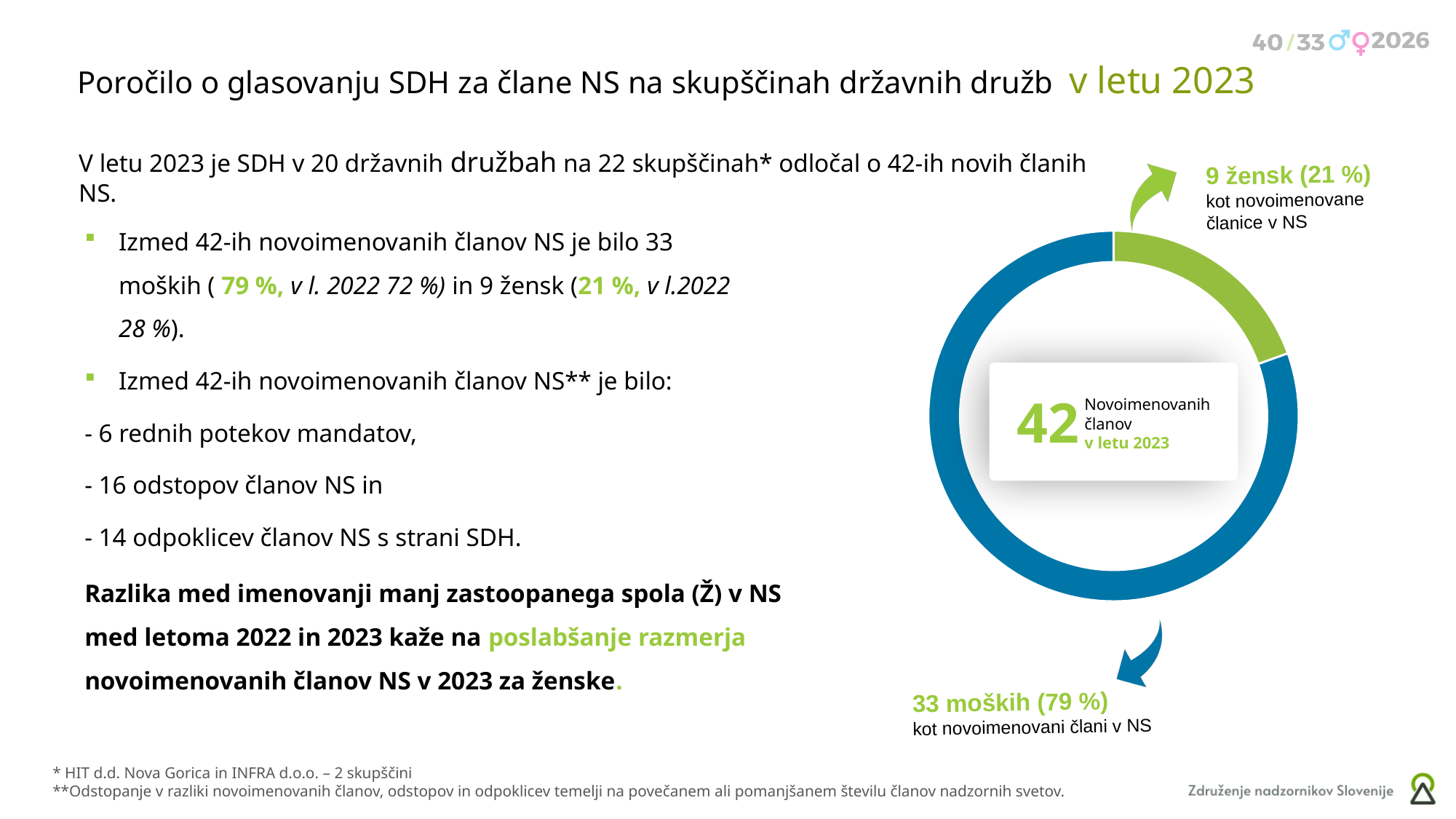
Which group has the smallest segment in the donut chart? Women (9 žensk) What total number of newly appointed members is shown in the centre of the donut chart? 42 What share of the donut chart do women (ženske) represent? 21 % How many segments does the donut chart have? 2 Which year does the donut chart refer to, according to its centre label? 2023 What share of the donut chart do men (moški) represent? 79 % Which group has the larger segment in the donut chart, men or women? Men (33 moških) What colour is the segment representing women in the donut chart? Green What kind of chart is shown on the slide? Donut chart What is the difference between the number of newly appointed men and women shown in the donut chart? 24 How many men were newly appointed as NS members according to the donut chart? 33 How many women were newly appointed as NS members according to the donut chart? 9